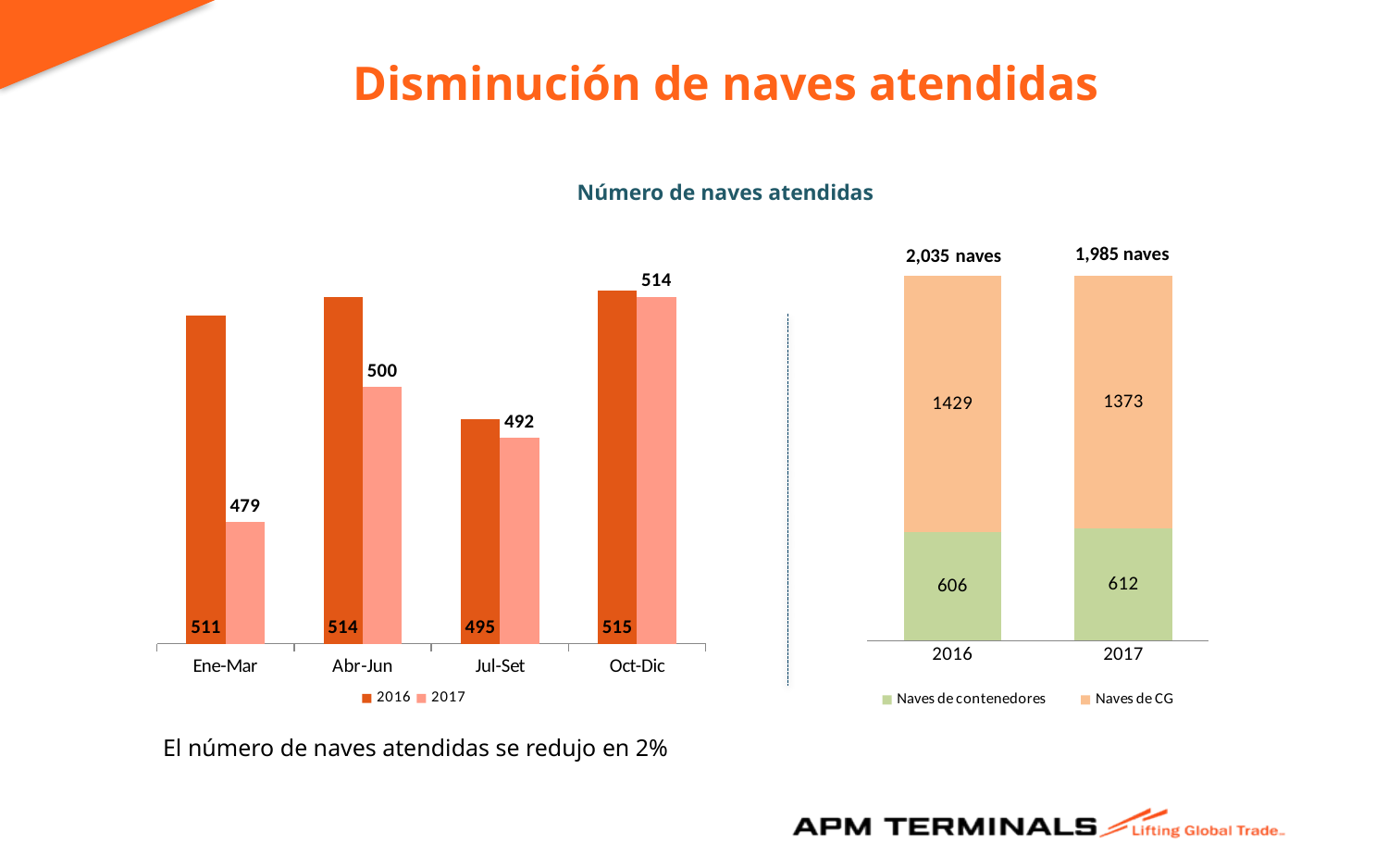
In the left chart (Número de naves atendidas), which quarter has the highest 2016 value? Oct-Dic What kind of chart is the right chart on the slide? Stacked bar chart In the right stacked chart, what is the difference between Naves de contenedores in 2017 and 2016? 6 In the right stacked chart, what is the total of the 2016 bar? 2,035 naves In the left chart (Número de naves atendidas), how many quarters are shown on the x axis? 4 In the left chart (Número de naves atendidas), what is the value for 2017 in Ene-Mar? 479 In the left chart (Número de naves atendidas), how many series does the legend list? 2 In the right stacked chart, what is the value for Naves de CG in 2017? 1373 In the left chart (Número de naves atendidas), which is larger in Abr-Jun: the 2016 value or the 2017 value? 2016 In the left chart (Número de naves atendidas), what is the value for 2016 in Jul-Set? 495 In the left chart (Número de naves atendidas), which quarter has the lowest 2017 value? Ene-Mar In the left chart (Número de naves atendidas), what is the difference between the 2016 and 2017 values for Ene-Mar? 32